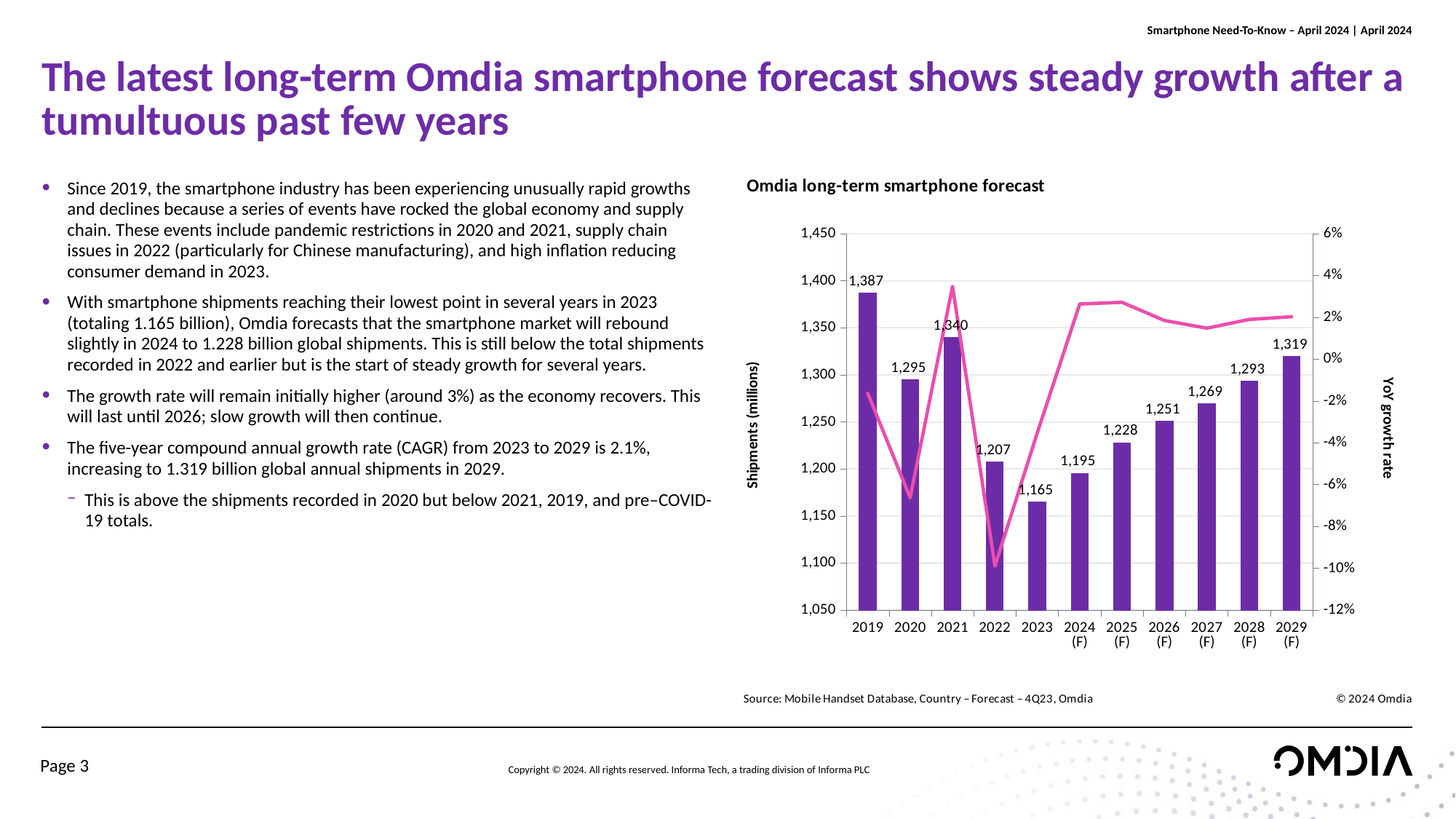
What is the difference in shipments between 2019 and 2023? 222 What is the forecast shipments value for 2029 (F)? 1,319 What is the shipments value for 2019 in the Omdia long-term smartphone forecast chart? 1,387 Which year has higher shipments, 2020 or 2021? 2021 What kind of chart is used for the Omdia long-term smartphone forecast? bar chart with a line Which year has the lowest shipments bar? 2023 Is the YoY growth rate for 2021 greater or less than 2%? greater How many years are shown on the x axis of the chart? 11 Is the YoY growth rate for 2022 greater or less than -8%? less What is the shipments value shown for 2023? 1,165 Which year has the highest shipments bar? 2019 Do the shipments bars rise or fall from 2023 to 2029 (F)? rise